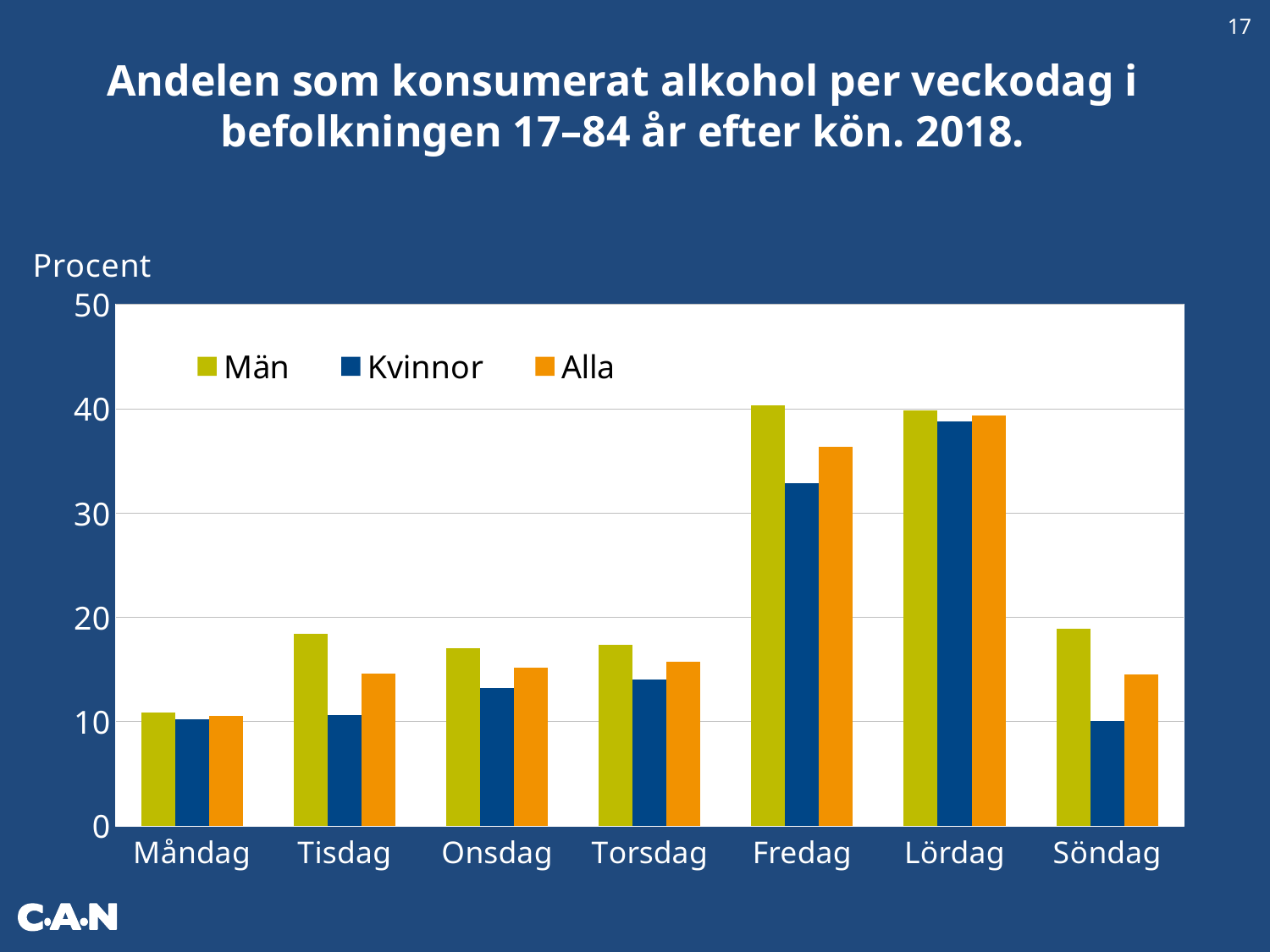
What kind of chart is shown on the slide? Bar chart On which weekday is the value for Alla lowest? Måndag What label is shown on the vertical axis of the chart? Procent On which weekday is the value for Män lowest? Måndag Is the value for Män on Tisdag greater or less than 20? less Which is larger on Söndag: the value for Män or the value for Alla? Män How many weekdays (categories) are shown on the x axis? 7 Is the value for Kvinnor on Onsdag greater or less than 10? greater Which is larger: the value for Kvinnor on Fredag or the value for Kvinnor on Lördag? Lördag On which weekday is the value for Kvinnor highest? Lördag Is the value for Kvinnor on Fredag greater or less than 30? greater How many series does the legend list? 3